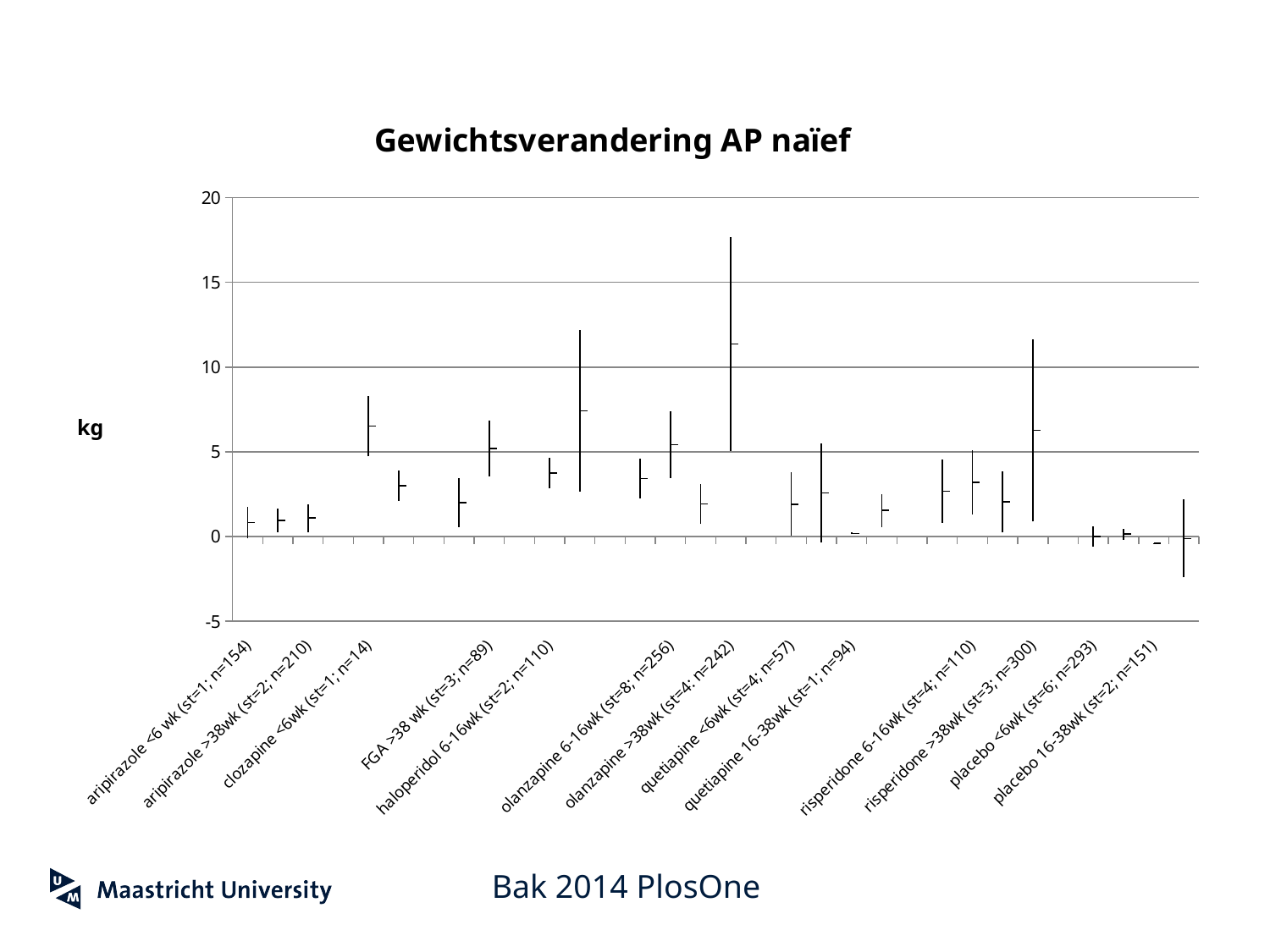
What is the minimum value shown on the vertical axis? -5 What unit is shown on the vertical axis of the chart? kg Is the upper end of the range for placebo 16-38wk (st=2; n=151) greater or less than 5? less Which has the higher upper end of its range, olanzapine >38wk (st=4; n=242) or quetiapine <6wk (st=4; n=57)? olanzapine >38wk (st=4; n=242) Is the upper end of the range for olanzapine >38wk (st=4; n=242) greater or less than 15? greater Is the upper end of the range for risperidone >38wk (st=3; n=300) greater or less than 10? greater Which has the higher upper end of its range, clozapine <6wk (st=1; n=14) or placebo <6wk (st=6; n=293)? clozapine <6wk (st=1; n=14) What source is cited below the chart? Bak 2014 PlosOne What is the maximum value shown on the vertical axis? 20 What is the title of the chart? Gewichtsverandering AP naïef Which category has the highest upper end of its range? olanzapine >38wk (st=4; n=242)